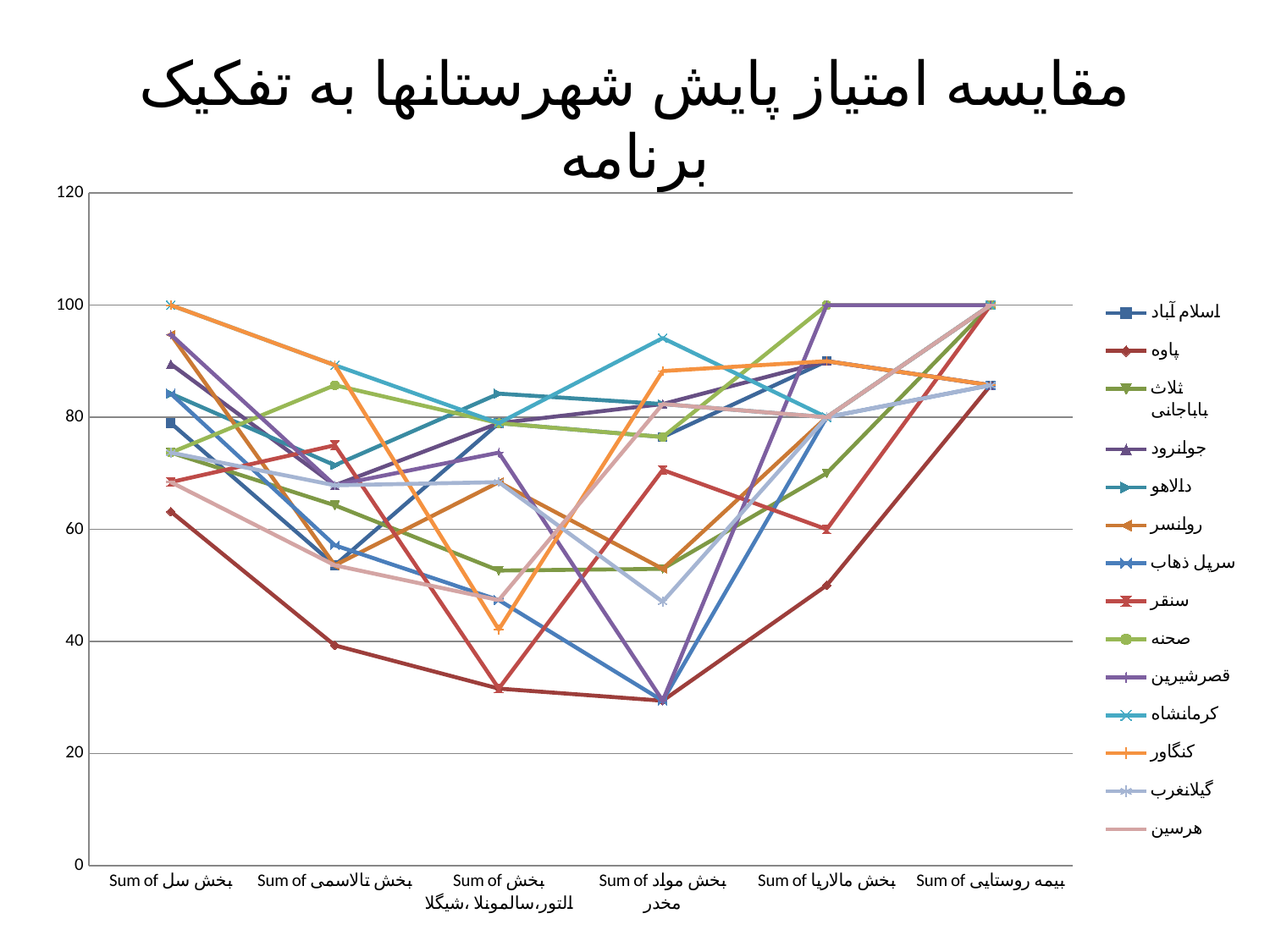
Is the value for پاوه at Sum of بخش مواد مخدر greater or less than 40? less How many series does the legend list? 14 Is the value for کنگاور at Sum of بخش سل greater or less than 80? greater For پاوه, which is larger: the value at Sum of بخش مالاریا or the value at Sum of بیمه روستایی? Sum of بیمه روستایی Is the value for کرمانشاه at Sum of بخش مواد مخدر greater or less than 80? greater What is the highest value shown on the y axis? 120 Does the پاوه line rise or fall from Sum of بخش سل to Sum of بخش مواد مخدر? fall At Sum of بخش سل, which is larger: the value for پاوه or the value for کنگاور? کنگاور What is the title of the chart? مقایسه امتیاز پایش شهرستانها به تفکیک برنامه What kind of chart is shown on the slide? line chart How many categories are shown along the x axis? 6